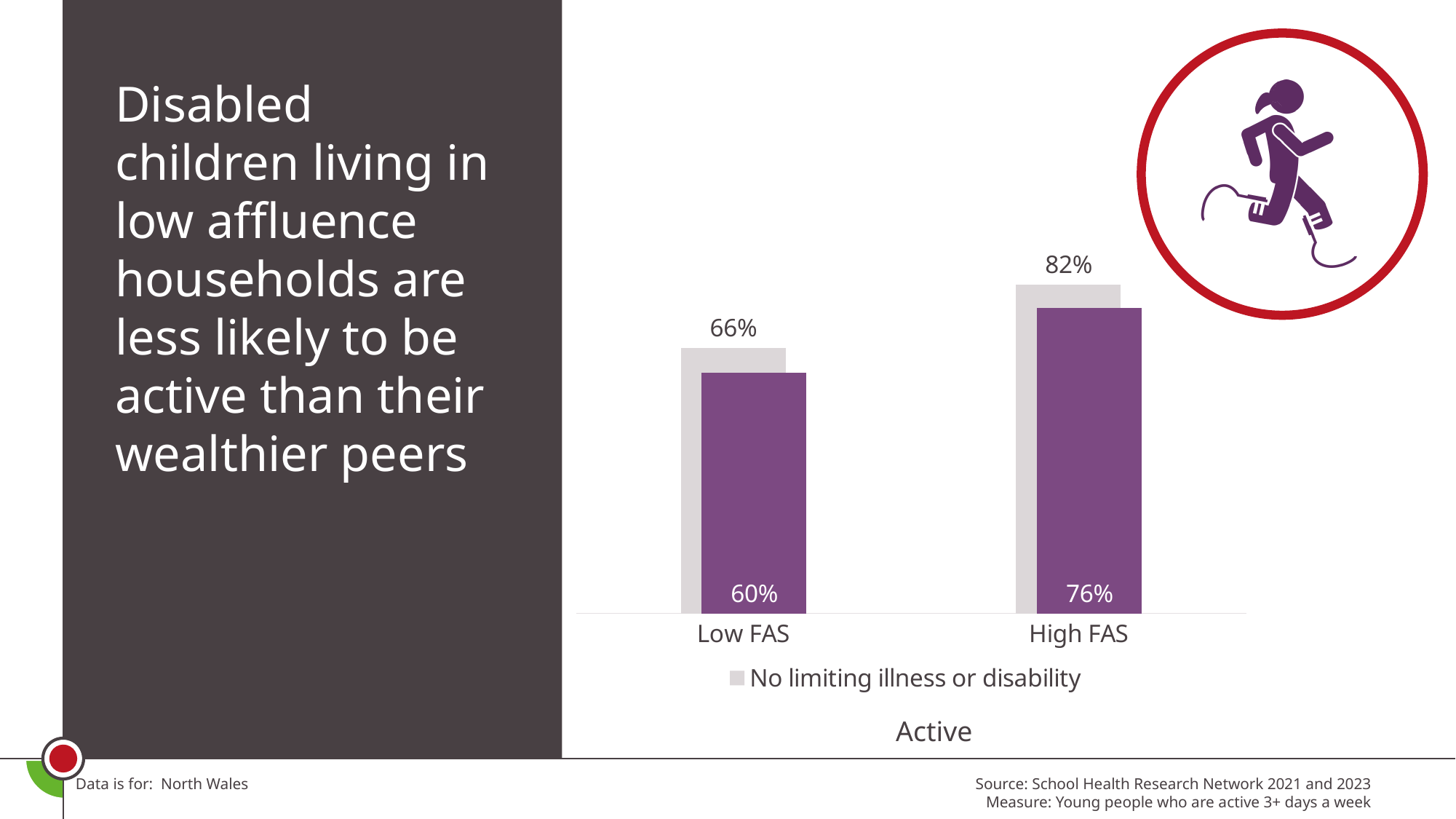
What is the value of the purple bar for High FAS? 76% What is the value for High FAS in the 'No limiting illness or disability' series? 82% What is the title shown below the chart? Active What kind of chart is shown on the slide? Bar chart What is the value for Low FAS in the 'No limiting illness or disability' series? 66% What is the value of the purple bar for Low FAS? 60% What is the difference between the purple bar values for High FAS and Low FAS? 16% How many categories are shown on the x axis? 2 What is the difference between the 'No limiting illness or disability' values for High FAS and Low FAS? 16% Which category has the higher value in the 'No limiting illness or disability' series, Low FAS or High FAS? High FAS For Low FAS, what is the difference between the grey bar and the purple bar? 6% What series name does the legend show? No limiting illness or disability